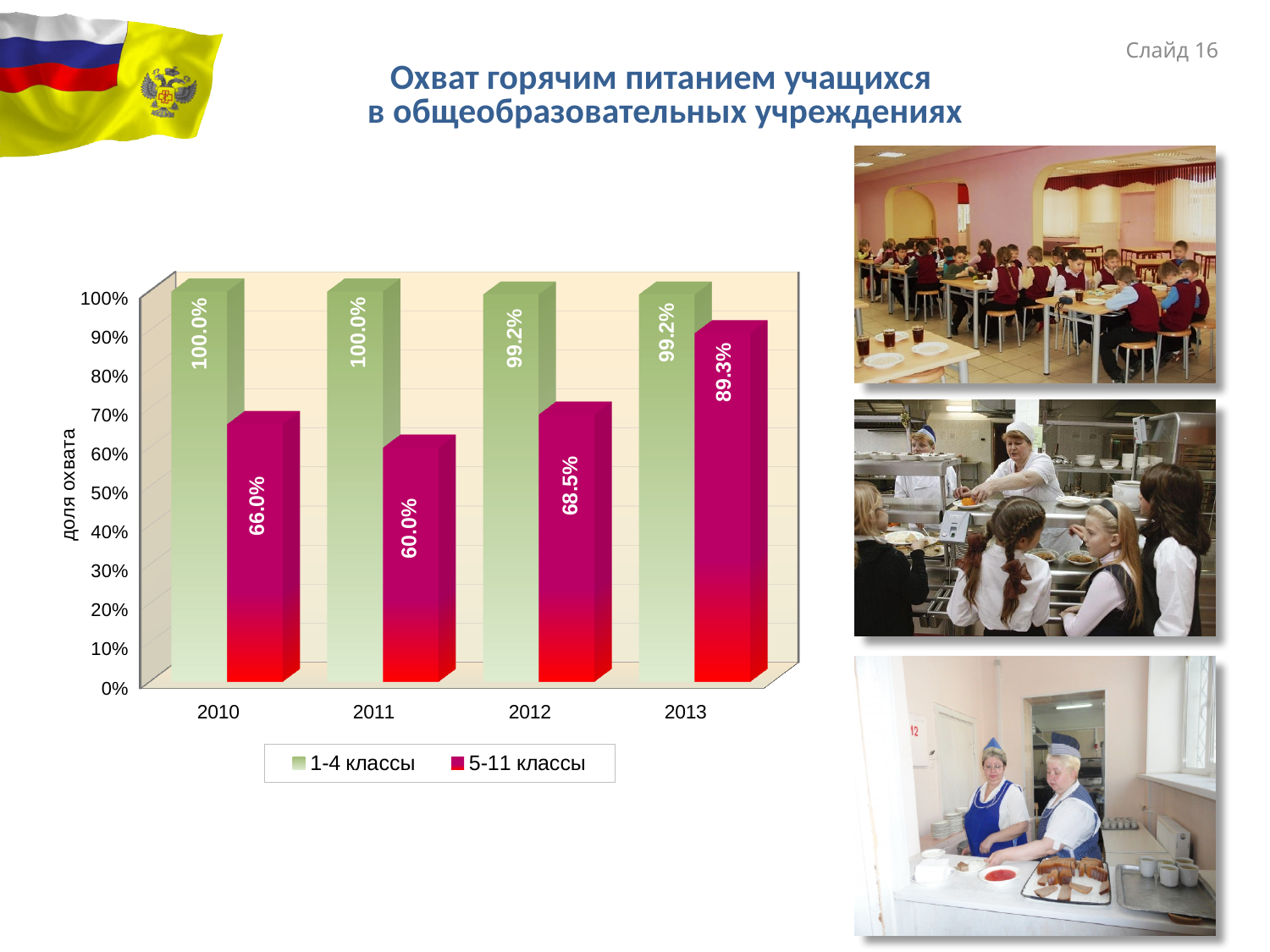
What is the difference between the 1-4 классы and 5-11 классы values in 2010? 34.0% In which year is the value for 5-11 классы highest? 2013 How many series does the legend list? 2 What kind of chart is shown on the slide? Bar chart In which year is the value for 5-11 классы lowest? 2011 What is the value for 5-11 классы in 2013? 89.3% What is the value for 1-4 классы in 2010? 100.0% What is the difference between the 5-11 классы values in 2013 and 2012? 20.8% What is the value for 5-11 классы in 2011? 60.0% What is the value for 1-4 классы in 2012? 99.2% How many years are shown on the x axis? 4 Which is larger in 2012: the value for 1-4 классы or for 5-11 классы? 1-4 классы